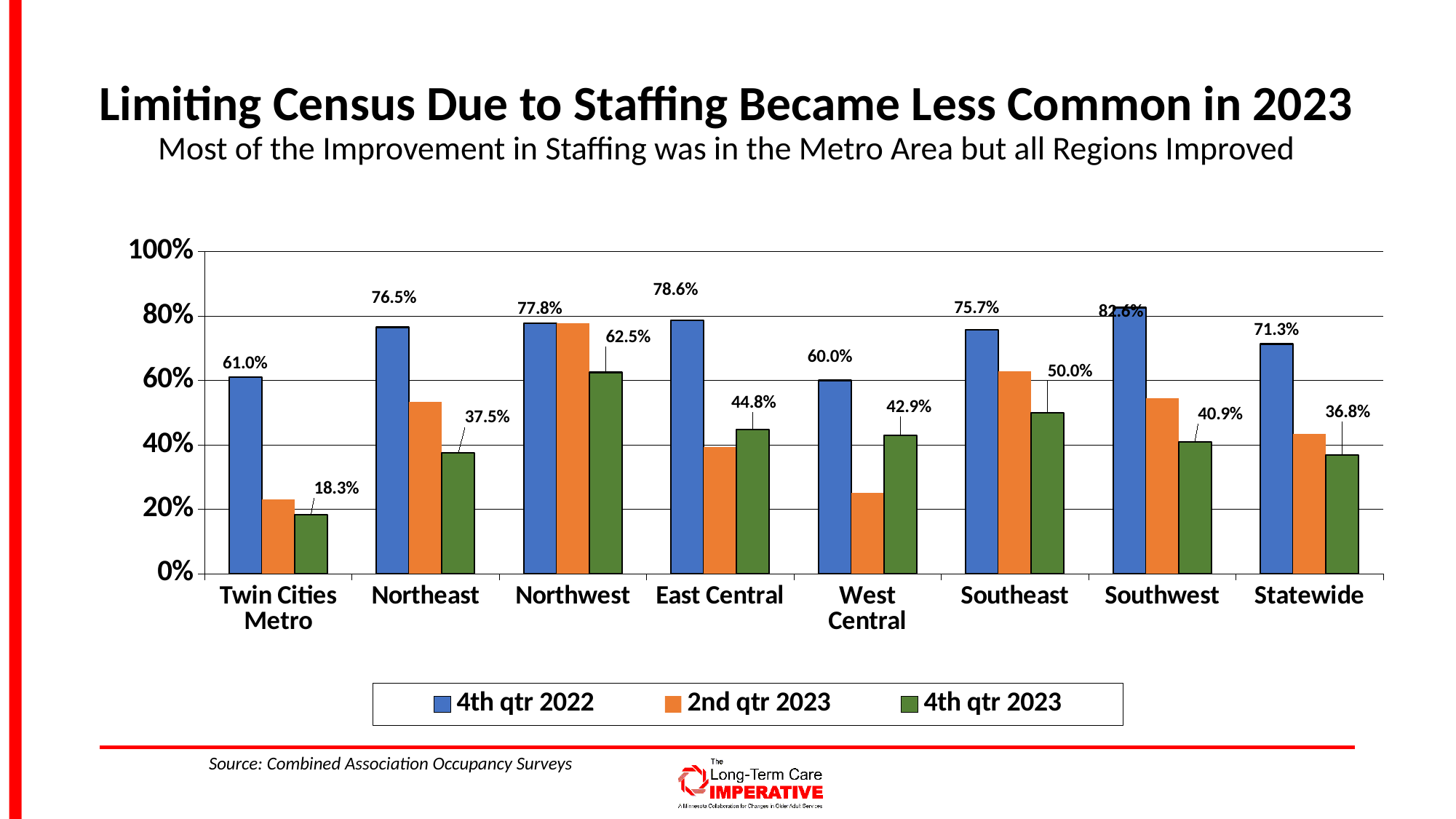
What is the 4th qtr 2022 value for East Central? 78.6% What is the 4th qtr 2023 value for Northwest? 62.5% Which region has the lowest 4th qtr 2023 value? Twin Cities Metro How many regions are shown on the x axis? 8 Is the 2nd qtr 2023 value for Twin Cities Metro greater or less than 40%? less What kind of chart is shown on the slide? Bar chart How many series does the legend list? 3 Which region has the highest 4th qtr 2023 value? Northwest What is the 4th qtr 2023 value for Statewide? 36.8% What is the difference between the 4th qtr 2022 and 4th qtr 2023 values for Twin Cities Metro? 42.7 percentage points Which is larger for Southeast: the 4th qtr 2022 value or the 4th qtr 2023 value? 4th qtr 2022 What is the 4th qtr 2022 value for Twin Cities Metro? 61.0%